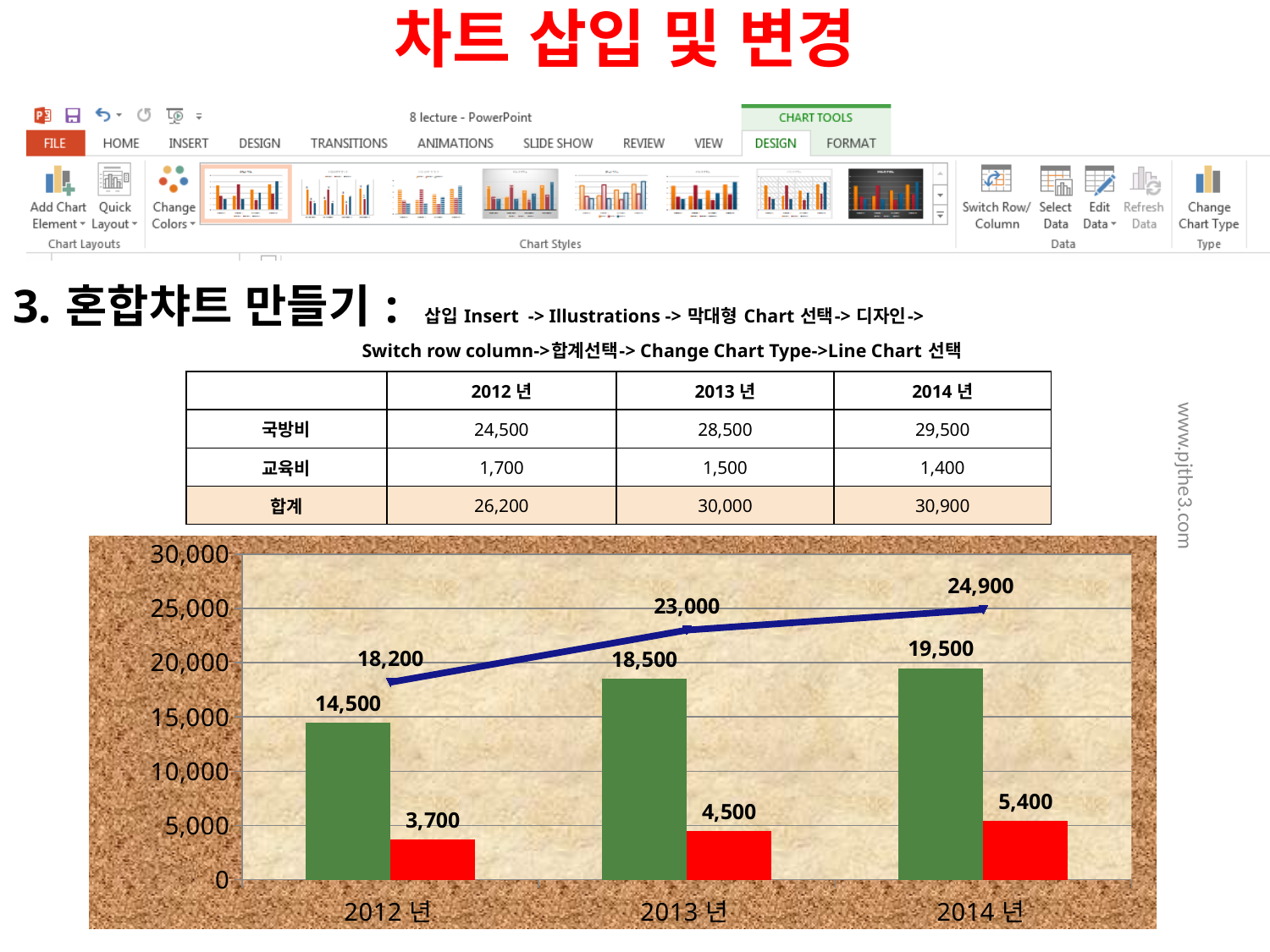
What is the value of the green bar for 2013 년? 18,500 What is the value of the red bar for 2014 년? 5,400 Which year has the lowest red bar? 2012 년 By how much does the line value increase from 2013 년 to 2014 년? 1,900 Which year has the highest green bar? 2014 년 Which is larger: the line value for 2013 년 or the green bar for 2014 년? the line value for 2013 년 How many years are shown on the x axis of the chart? 3 What is the difference between the green bar and the red bar for 2012 년? 10,800 Does the line series rise or fall from 2012 년 to 2014 년? rise What kind of chart is shown at the bottom of the slide? a combination bar and line chart What is the sum of the green bar and the red bar for 2013 년? 23,000 What value does the line series show for 2012 년? 18,200